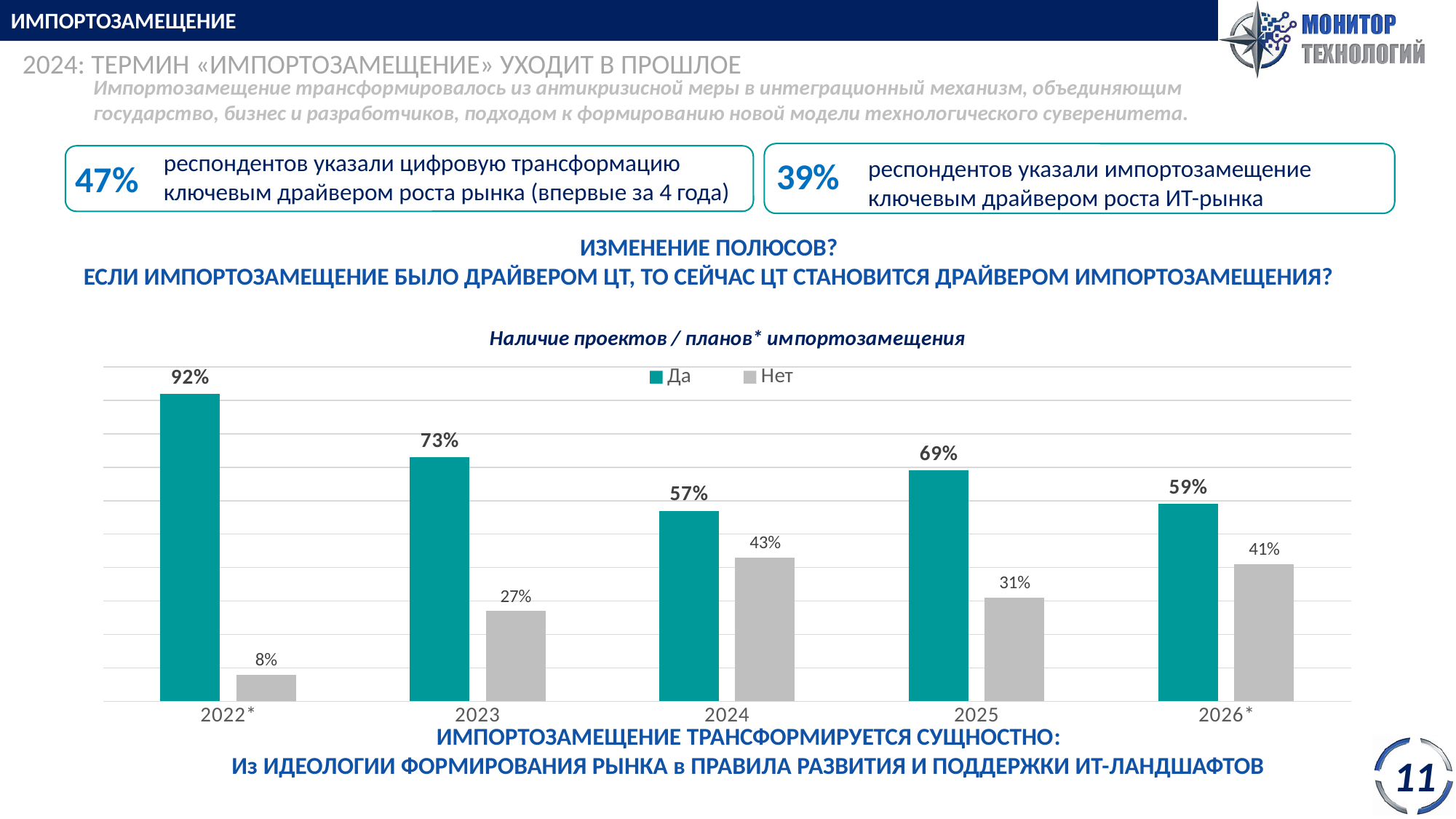
Does the "Да" series rise or fall from 2022* to 2024? Fall In which year is the "Нет" series lowest? 2022* In which year is the "Да" series highest? 2022* What is the value of the "Да" series for 2025? 69% Which is larger for 2024: the "Да" value or the "Нет" value? Да What are the two legend entries of the chart? Да and Нет What is the difference between the "Да" values for 2022* and 2023? 19% How many series does the chart legend list? 2 What is the value of the "Да" series for 2022* in the chart "Наличие проектов / планов* импортозамещения"? 92% What kind of chart is shown on the slide? Bar chart What is the value of the "Нет" series for 2024? 43% How many years are shown on the x axis of the chart? 5